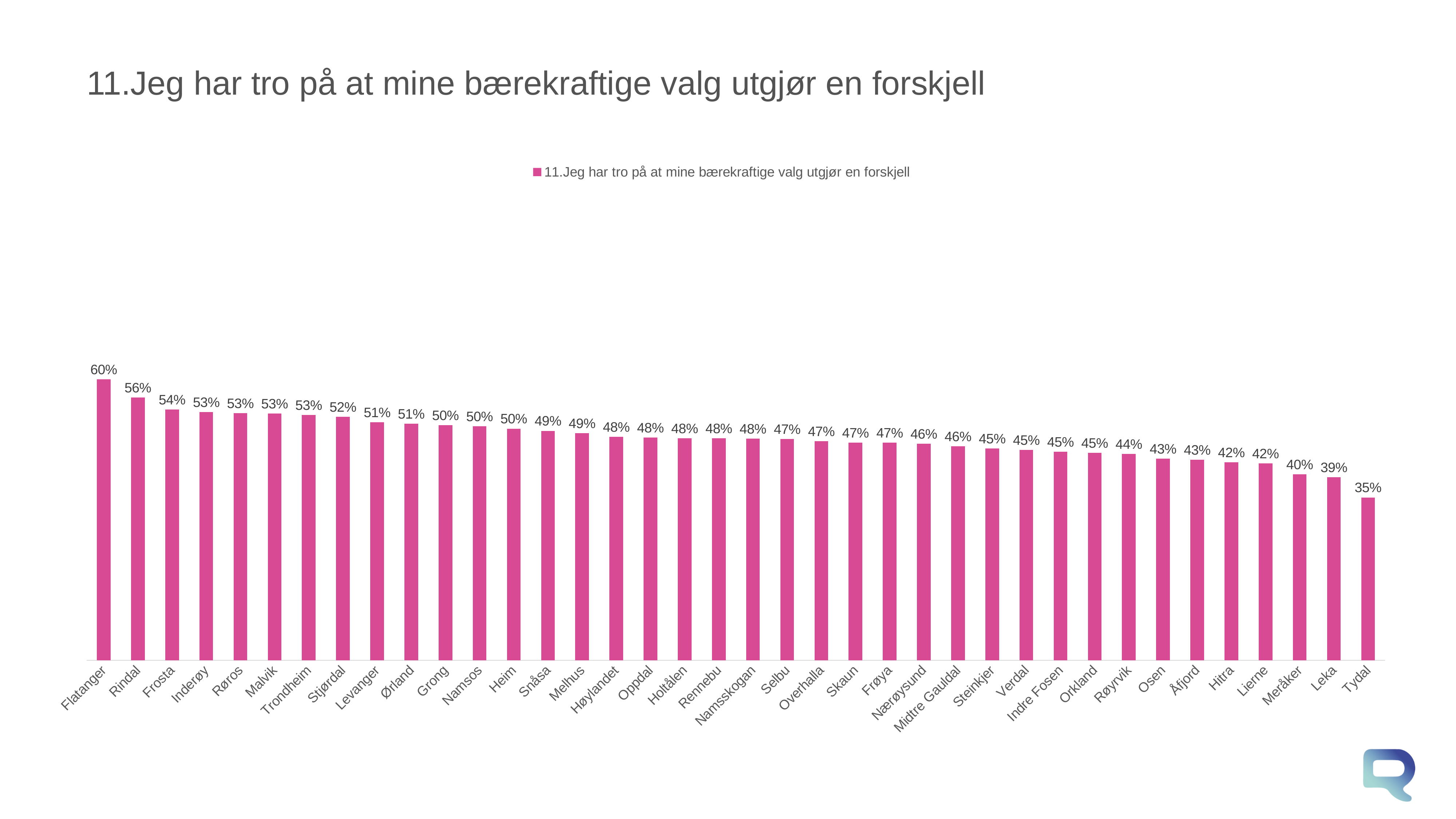
Do the values rise or fall from left to right along the x axis? Fall What is the difference between the values for Rindal and Leka? 17% What kind of chart is shown? Bar chart What is the value for Trondheim? 53% Which category has the lowest value? Tydal How many categories are shown on the x axis? 38 Which category has the highest value? Flatanger How many series does the legend list? 1 What is the difference between the values for Flatanger and Tydal? 25% What is the value for Flatanger? 60% What is the value for Steinkjer? 45% Which is larger, the value for Frosta or the value for Meråker? Frosta